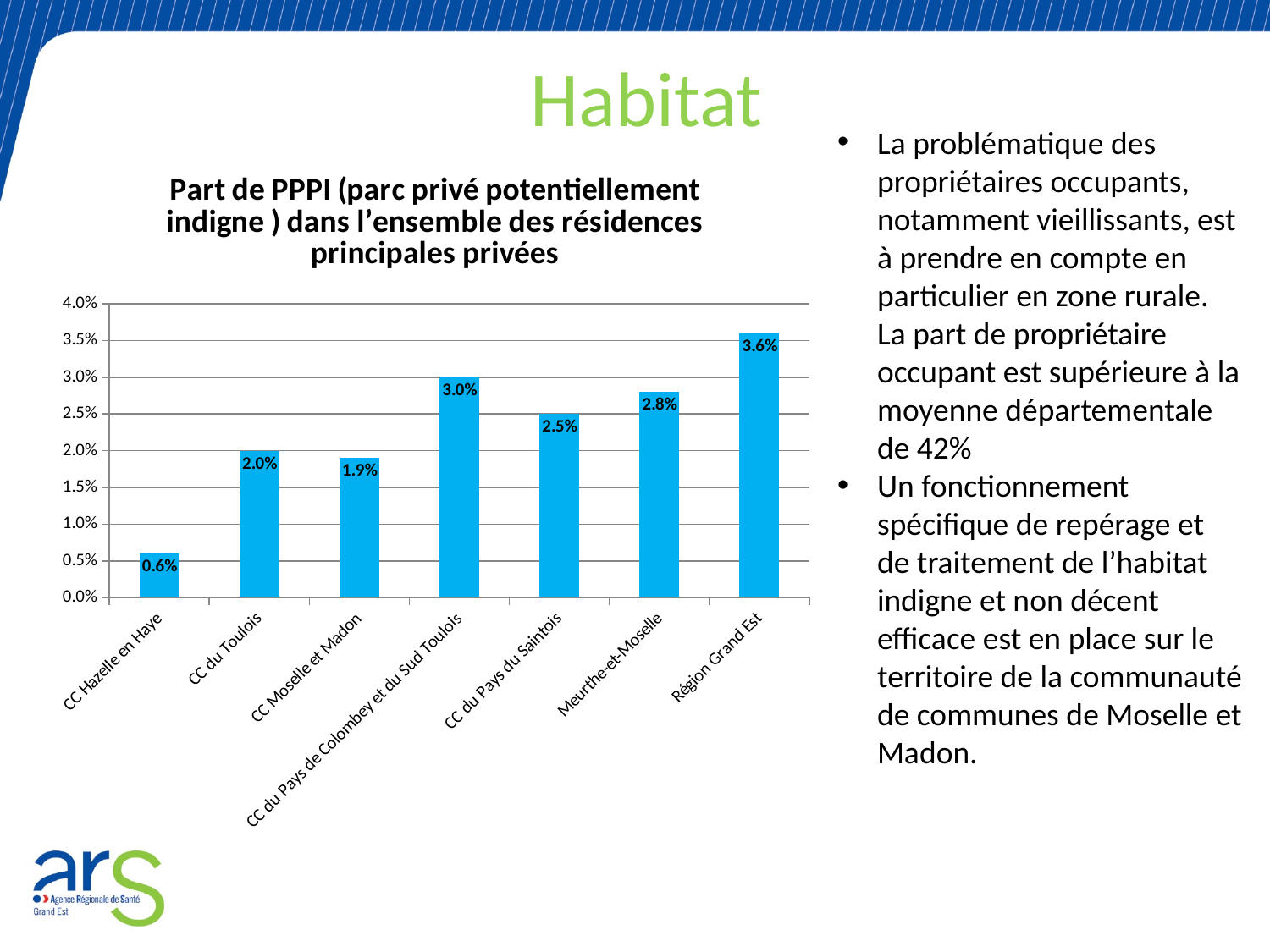
What is the title of the chart? Part de PPPI (parc privé potentiellement indigne ) dans l'ensemble des résidences principales privées What is the value for CC Moselle et Madon? 1.9% Which category has the lowest value? CC Hazelle en Haye What is the value for Meurthe-et-Moselle? 2.8% How many categories are shown on the x axis? 7 Which category has the highest value? Région Grand Est What is the difference between the values for Région Grand Est and CC Hazelle en Haye? 3.0% What is the difference between the values for CC du Pays de Colombey et du Sud Toulois and CC du Pays du Saintois? 0.5% What kind of chart is shown on the slide? Bar chart What is the value for CC Hazelle en Haye? 0.6% Which is larger, the value for CC du Toulois or the value for CC du Pays du Saintois? CC du Pays du Saintois What is the value for CC du Pays de Colombey et du Sud Toulois? 3.0%